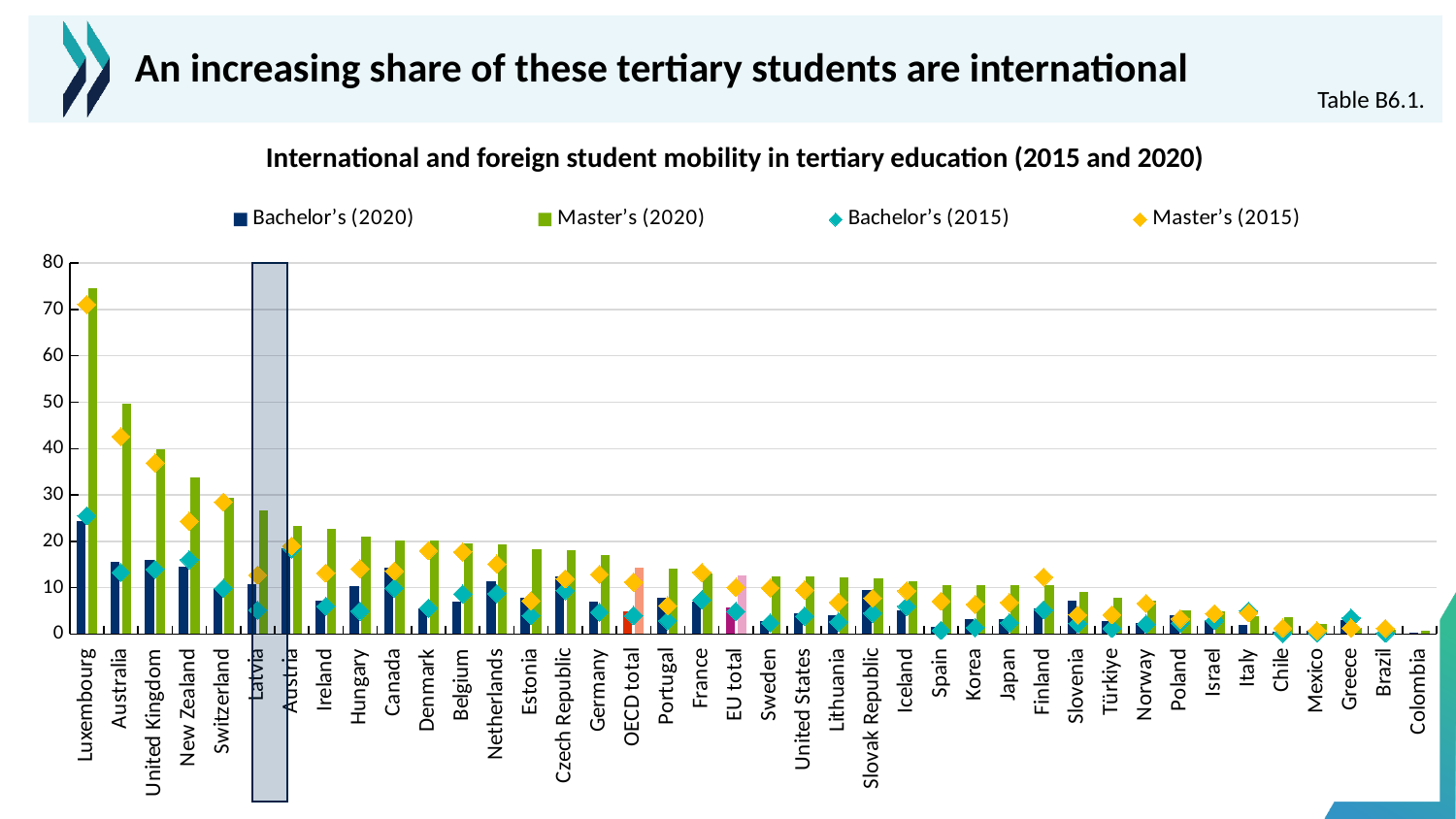
How many countries or groups are shown along the x axis of the chart? 40 Is the Master's (2020) value for Latvia greater or less than 20? greater Is the Bachelor's (2020) value for Austria greater or less than 20? less How many series does the chart's legend list? 4 Which country has the highest Bachelor's (2020) value in the chart? Luxembourg Is the Master's (2020) value for Australia greater or less than 40? greater What is the title of the chart? International and foreign student mobility in tertiary education (2015 and 2020) Which country is highlighted with a shaded box on the chart? Latvia Do the Master's (2020) values generally rise or fall moving from left to right along the x axis? fall For Australia, which is larger: the Bachelor's (2020) value or the Master's (2020) value? Master's (2020) Which country has the highest Master's (2020) value in the chart? Luxembourg